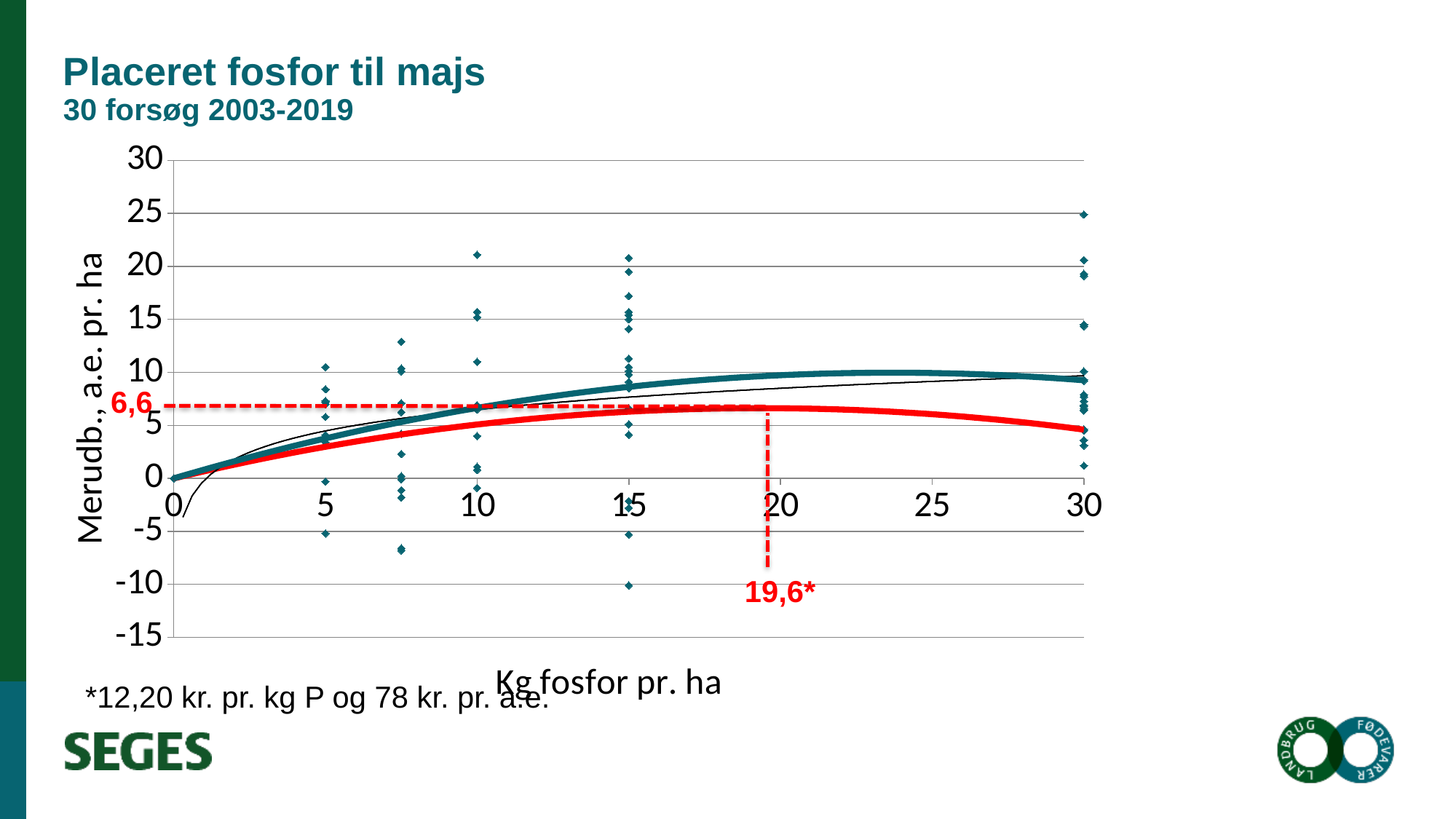
Is the highest scatter point at 30 kg fosfor pr. ha greater or less than 20? greater What is the title of the chart on the slide? Placeret fosfor til majs What is the highest value shown on the x axis? 30 What is the label of the y axis? Merudb., a.e. pr. ha What is the lowest value shown on the y axis? -15 Is the value of the teal curve at 30 kg fosfor pr. ha greater or less than 5? greater What value is marked by the red dashed horizontal line? 6,6 At 30 kg fosfor pr. ha, which curve is higher, the teal curve or the red curve? The teal curve What x-axis value is marked by the red dashed vertical line? 19,6* Is the value of the red curve at 30 kg fosfor pr. ha greater or less than 10? less What kind of chart is shown on the slide? Scatter chart with fitted curves